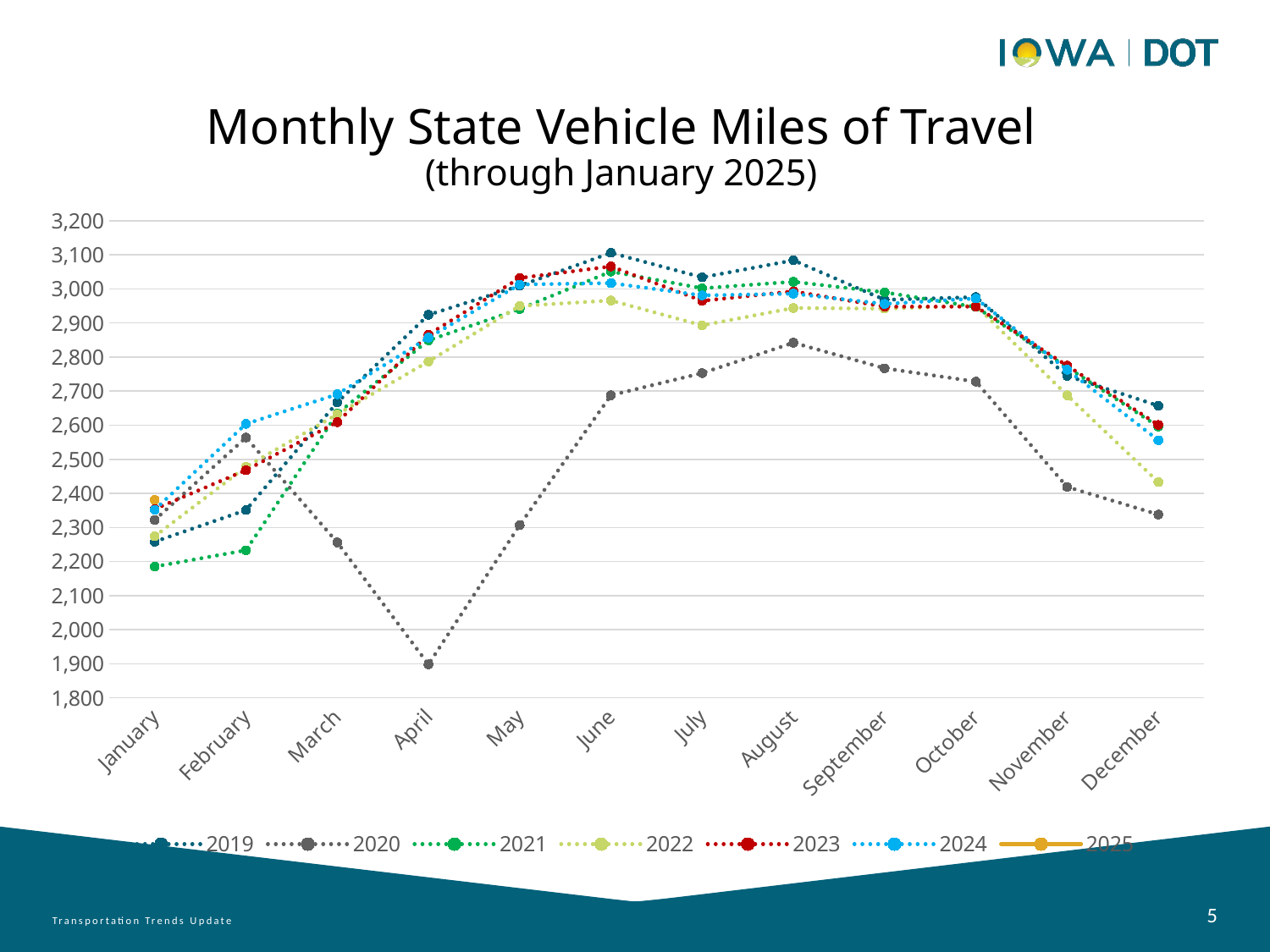
What is the title of the chart? Monthly State Vehicle Miles of Travel (through January 2025) Is the value for 2020 in April greater or less than 2,000? less Does the 2020 series rise or fall from March to April? fall How many months are shown along the x axis? 12 Is the value for 2021 in January greater or less than 2,300? less Which series has the lowest value in August? 2020 Which is larger in April, the value for 2019 or the value for 2020? 2019 Is the value for 2019 in June greater or less than 3,000? greater Which month has the lowest value for the 2020 series? April How many series does the legend list? 7 What kind of chart is shown on the slide? line chart